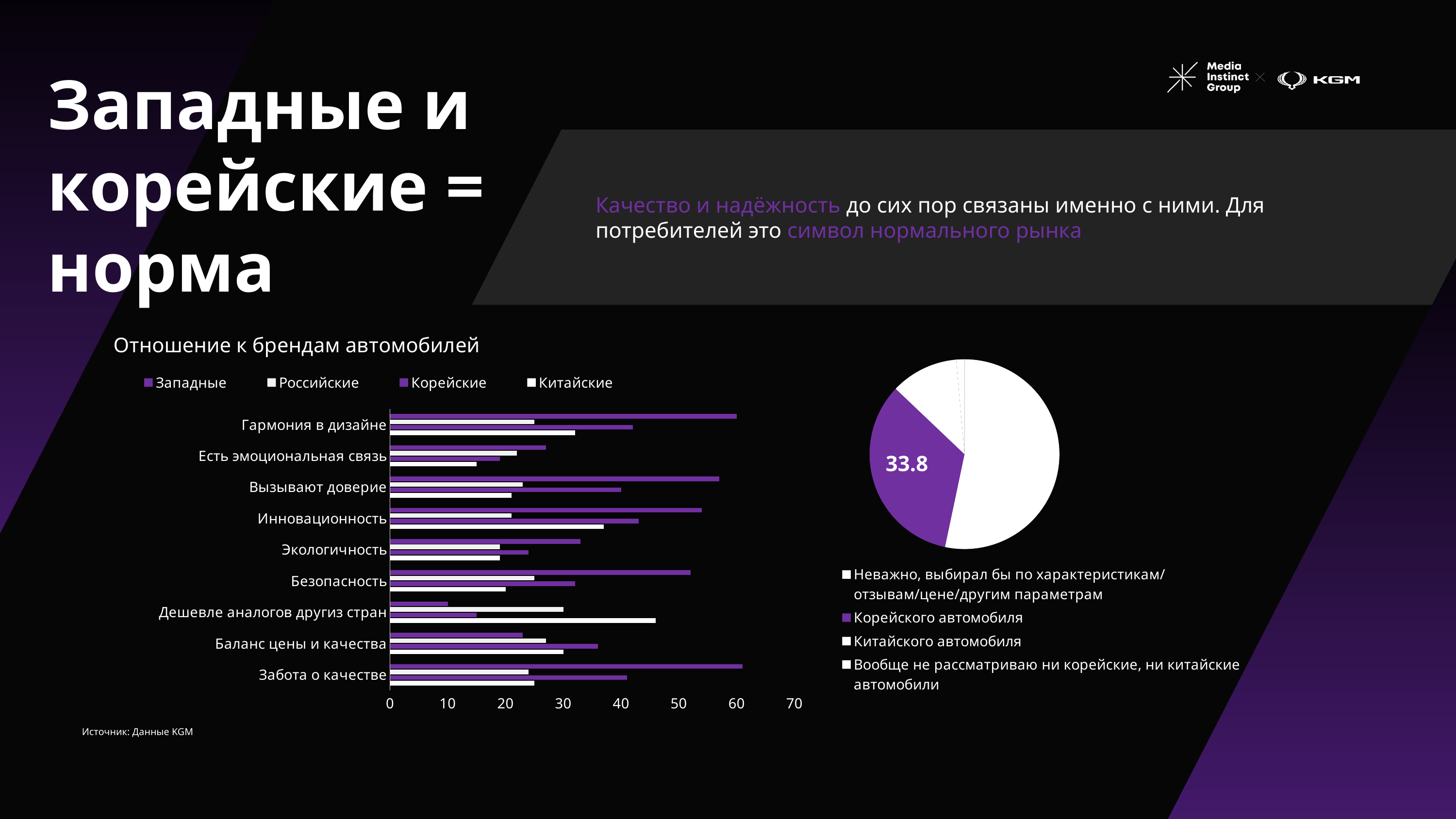
In the pie chart on the right of the slide, how many entries does the legend list? 4 In the chart "Отношение к брендам автомобилей", which is larger for "Дешевле аналогов другиз стран": Китайские or Западные? Китайские What kind of chart is the chart titled "Отношение к брендам автомобилей"? bar chart In the chart "Отношение к брендам автомобилей", is the value for Корейские in "Инновационность" greater or less than 40? greater In the chart "Отношение к брендам автомобилей", how many categories are shown on the vertical axis? 9 In the chart "Отношение к брендам автомобилей", is the value for Западные in "Гармония в дизайне" greater or less than 50? greater In the chart "Отношение к брендам автомобилей", is the value for Западные in "Дешевле аналогов другиз стран" greater or less than 20? less In the chart "Отношение к брендам автомобилей", which series has the highest value for "Вызывают доверие"? Западные In the pie chart on the right of the slide, what value is shown for the slice "Корейского автомобиля"? 33.8 What is the title of the bar chart on the left of the slide? Отношение к брендам автомобилей In the chart "Отношение к брендам автомобилей", which series has the lowest value for "Есть эмоциональная связь"? Китайские In the chart "Отношение к брендам автомобилей", how many series does the legend list? 4